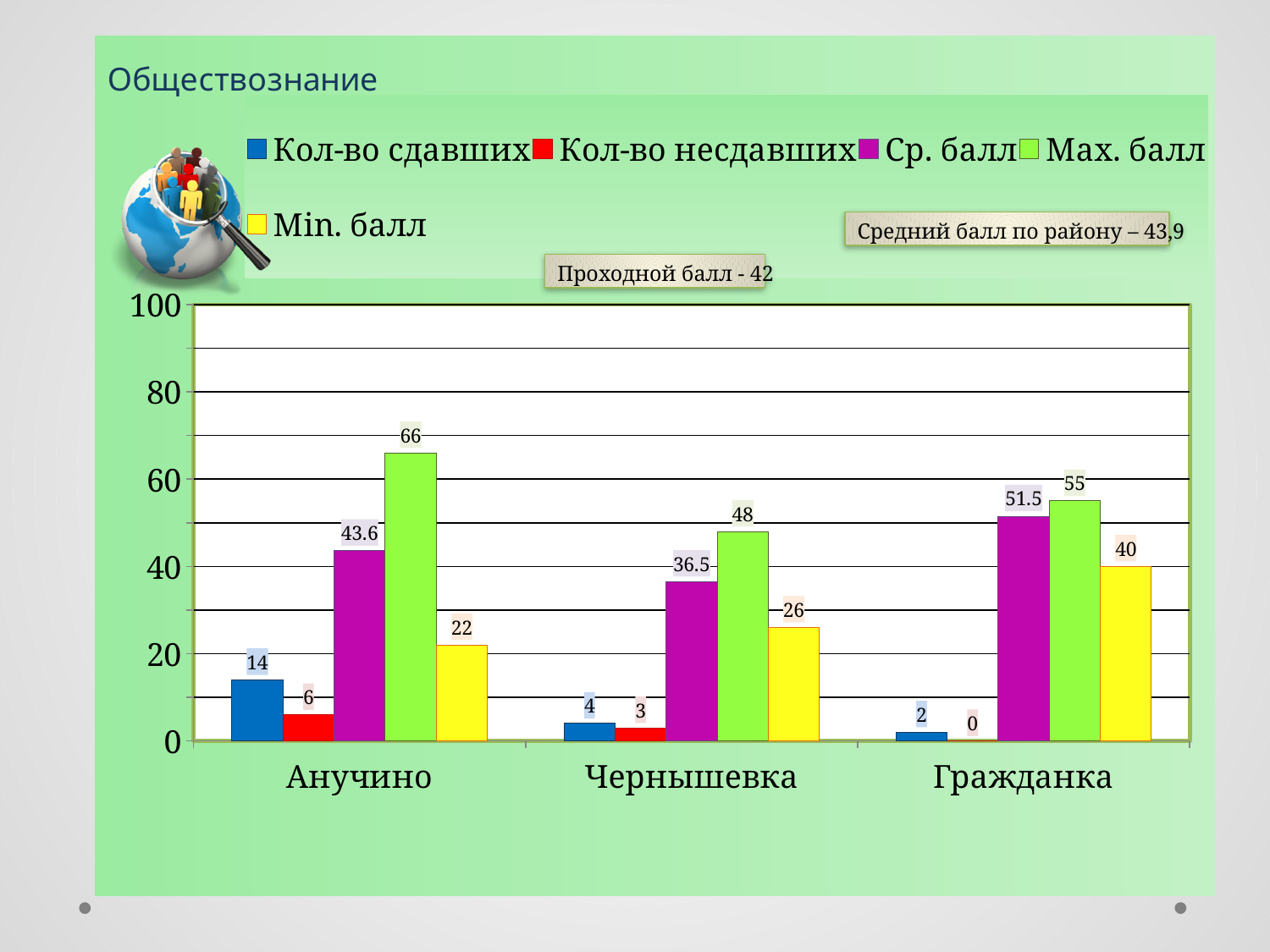
Which category has the highest Кол-во сдавших value? Анучино What is the Max. балл value for Анучино? 66 How many series does the legend list? 5 How many categories are shown on the x axis? 3 Which is larger: the Min. балл for Гражданка or the Min. балл for Анучино? Гражданка Which category has the lowest Ср. балл value? Чернышевка What kind of chart is shown on the slide? bar chart Is the Ср. балл value for Гражданка greater or less than 40? greater What is the Min. балл value for Чернышевка? 26 What is the Кол-во несдавших value for Гражданка? 0 What is the Ср. балл value for Чернышевка? 36.5 What is the difference between the Max. балл values for Анучино and Гражданка? 11